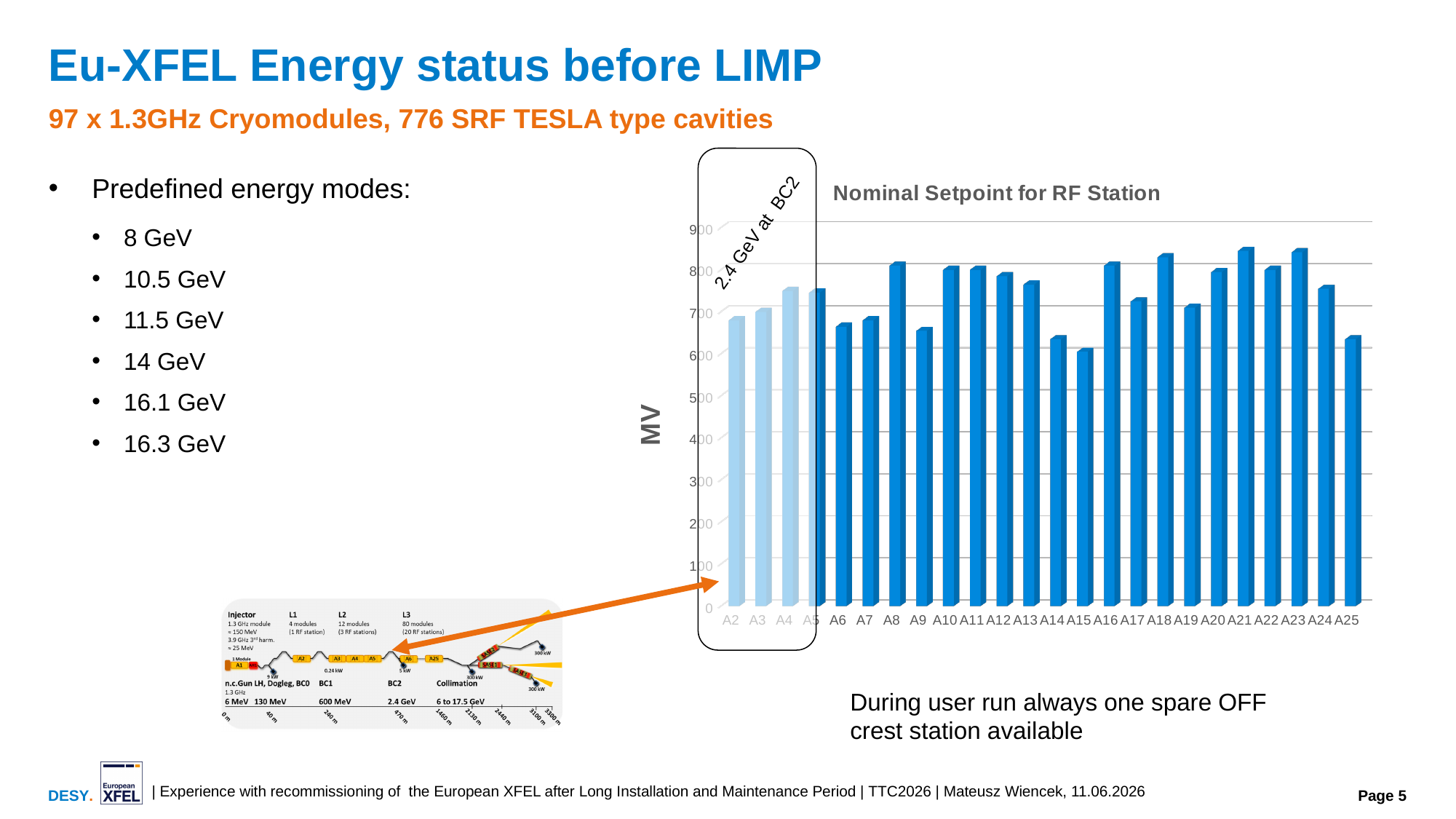
Is the value for A18 greater or less than 800? greater Is the value for A21 greater or less than 800? greater Is the value for A14 greater or less than 700? less Which has the larger nominal setpoint, A8 or A9? A8 Which has the larger nominal setpoint, A21 or A25? A21 What type of chart is shown on the slide? bar chart Which has the larger nominal setpoint, A15 or A16? A16 Which RF station has the lowest nominal setpoint in the chart? A15 How many RF stations (categories) are plotted on the x axis of the chart? 24 What is the title of the chart? Nominal Setpoint for RF Station What is the label on the vertical axis of the chart? MV